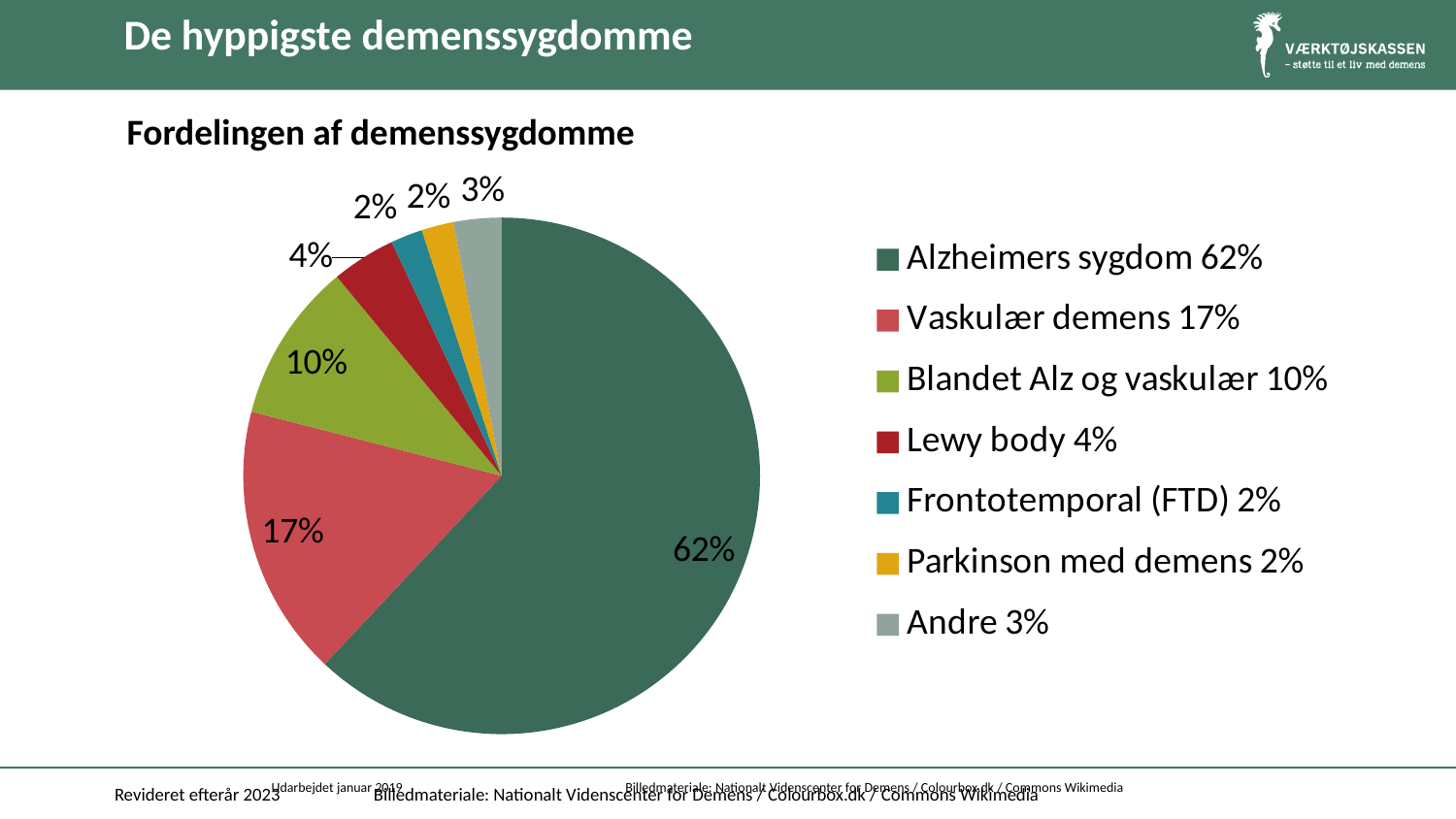
What share of the pie does Vaskulær demens have? 17% What is the difference between the shares of Alzheimers sygdom and Vaskulær demens? 45% What is the title of the chart? Fordelingen af demenssygdomme Which is larger, the share for Lewy body or the share for Andre? Lewy body What share of the pie does Andre have? 3% What share of the pie does Blandet Alz og vaskulær have? 10% Which category has the largest slice of the pie? Alzheimers sygdom What kind of chart is shown on the slide? pie chart How many slices does the pie chart have? 7 What colour is the slice for Parkinson med demens? yellow